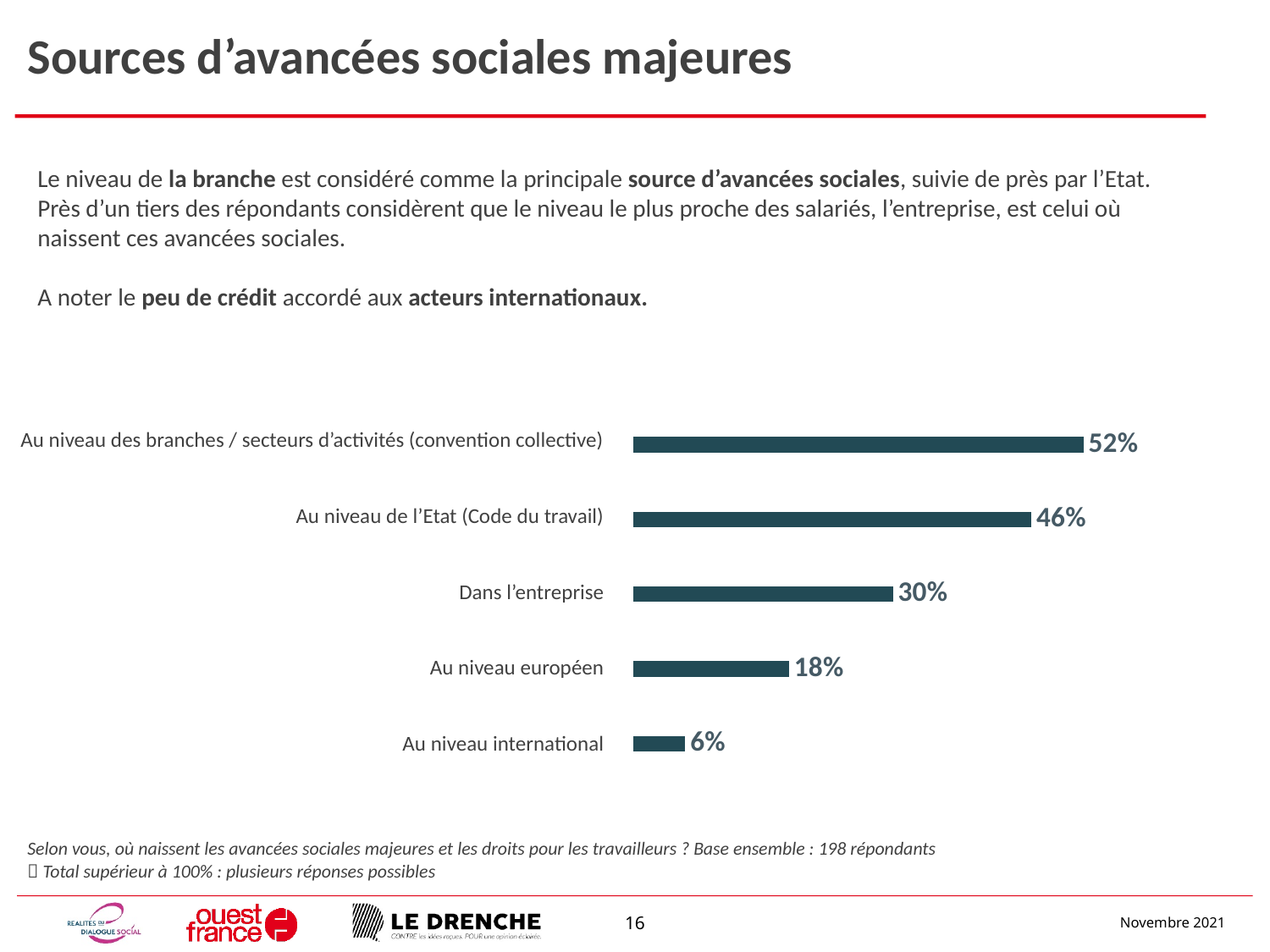
What is the difference between the values for "Dans l'entreprise" and "Au niveau européen"? 12% How many categories are shown in the chart? 5 What kind of chart is shown on the slide? Bar chart What is the value for "Au niveau de l'Etat (Code du travail)"? 46% What is the difference between the values for "Au niveau des branches / secteurs d'activités (convention collective)" and "Au niveau de l'Etat (Code du travail)"? 6% What is the value for "Au niveau international"? 6% What is the value for "Au niveau des branches / secteurs d'activités (convention collective)"? 52% Which category has the highest value? Au niveau des branches / secteurs d'activités (convention collective) What is the value for "Dans l'entreprise"? 30% Which is larger, the value for "Au niveau européen" or the value for "Au niveau international"? Au niveau européen What is the value for "Au niveau européen"? 18% Which category has the lowest value? Au niveau international